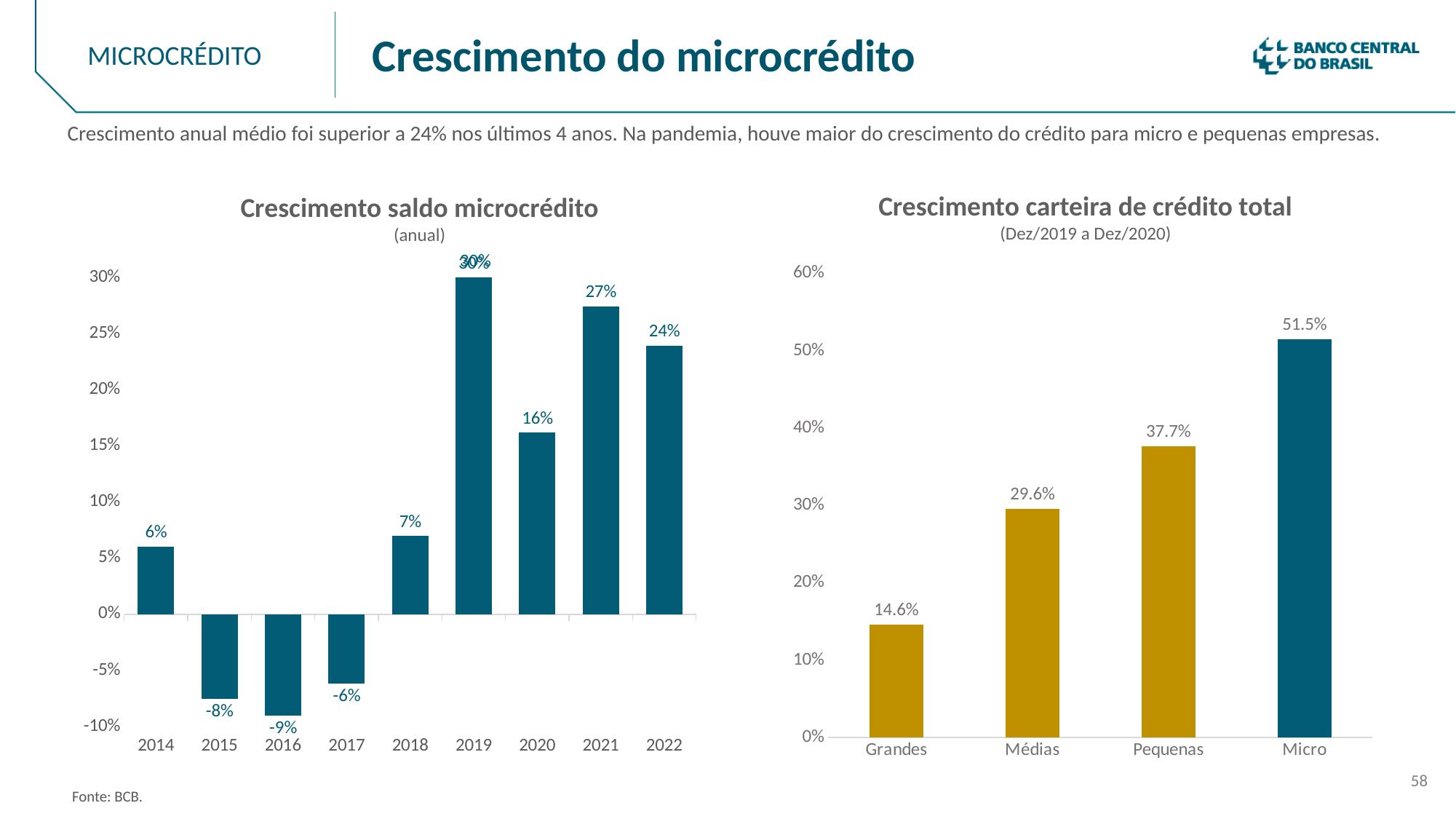
In the chart 'Crescimento saldo microcrédito', which year has the highest value? 2019 In the chart 'Crescimento saldo microcrédito', how many years are shown on the x axis? 9 What kind of chart is 'Crescimento carteira de crédito total'? bar chart In the chart 'Crescimento carteira de crédito total', what is the difference between the values for Micro and Grandes? 36.9% In the chart 'Crescimento carteira de crédito total', which is larger, the value for Médias or the value for Pequenas? Pequenas In the chart 'Crescimento saldo microcrédito', do the values rise or fall from 2014 to 2016? fall In the chart 'Crescimento saldo microcrédito', what is the difference between the values for 2019 and 2020? 14% In the chart 'Crescimento saldo microcrédito', what is the value for 2021? 27% In the chart 'Crescimento carteira de crédito total', what is the value for Pequenas? 37.7% In the chart 'Crescimento saldo microcrédito', what is the value for 2016? -9% In the chart 'Crescimento carteira de crédito total', which category has the highest value? Micro In the chart 'Crescimento saldo microcrédito', which year has the lowest value? 2016